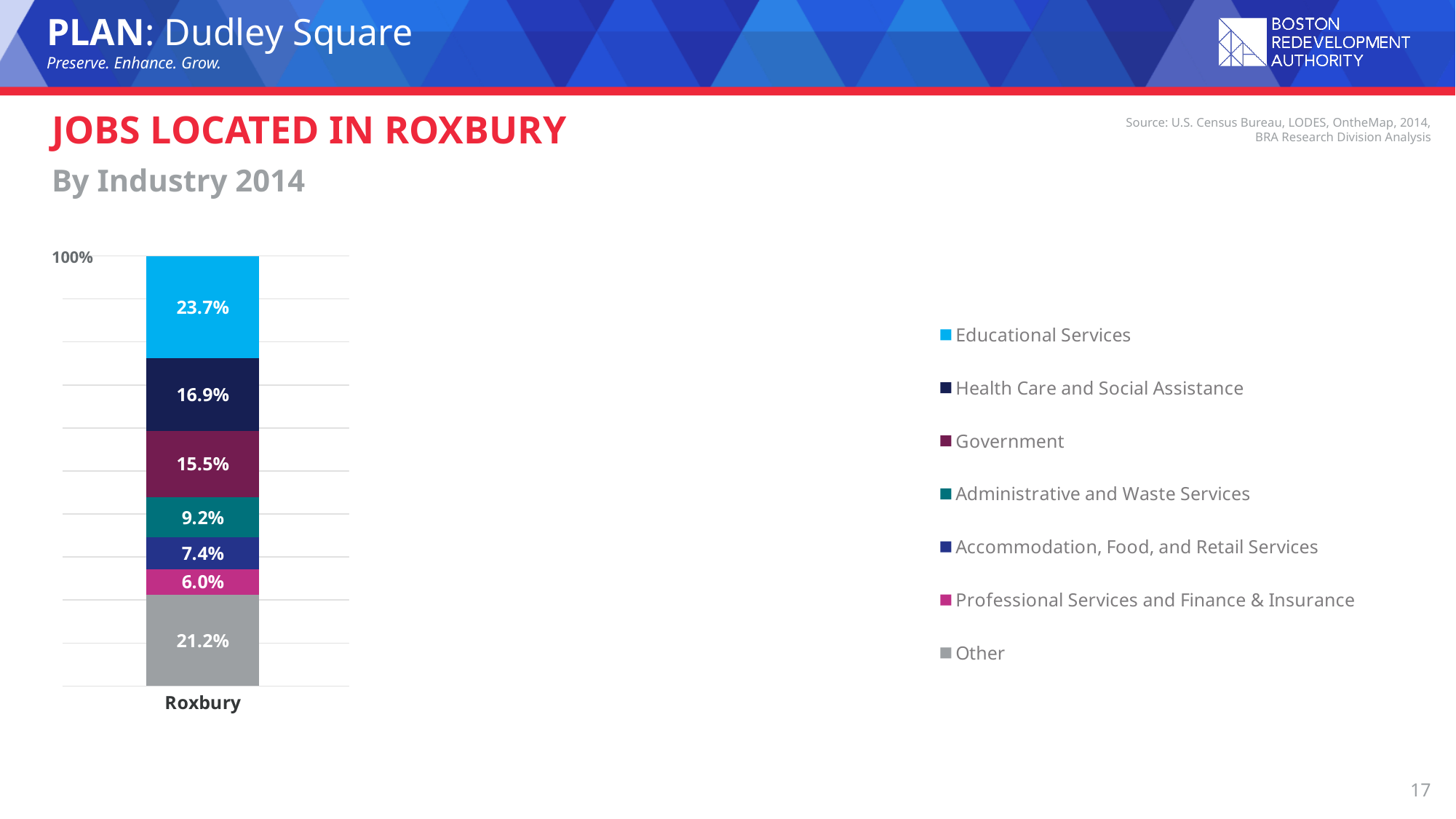
How many industry segments make up the Roxbury bar? 7 What share of jobs located in Roxbury is in Health Care and Social Assistance? 16.9% Which is larger: the share for Administrative and Waste Services or the share for Accommodation, Food, and Retail Services? Administrative and Waste Services What share of jobs located in Roxbury is in Professional Services and Finance & Insurance? 6.0% What kind of chart is shown on the slide? Stacked bar chart Which industry has the smallest share of jobs located in Roxbury? Professional Services and Finance & Insurance What is the subtitle of the chart? By Industry 2014 What share of jobs located in Roxbury is in Government? 15.5% How many series does the legend list? 7 Which named industry (excluding Other) has the largest share of jobs located in Roxbury? Educational Services What is the difference between the Educational Services share and the Health Care and Social Assistance share of jobs in Roxbury? 6.8% What share of jobs located in Roxbury is in Educational Services? 23.7%